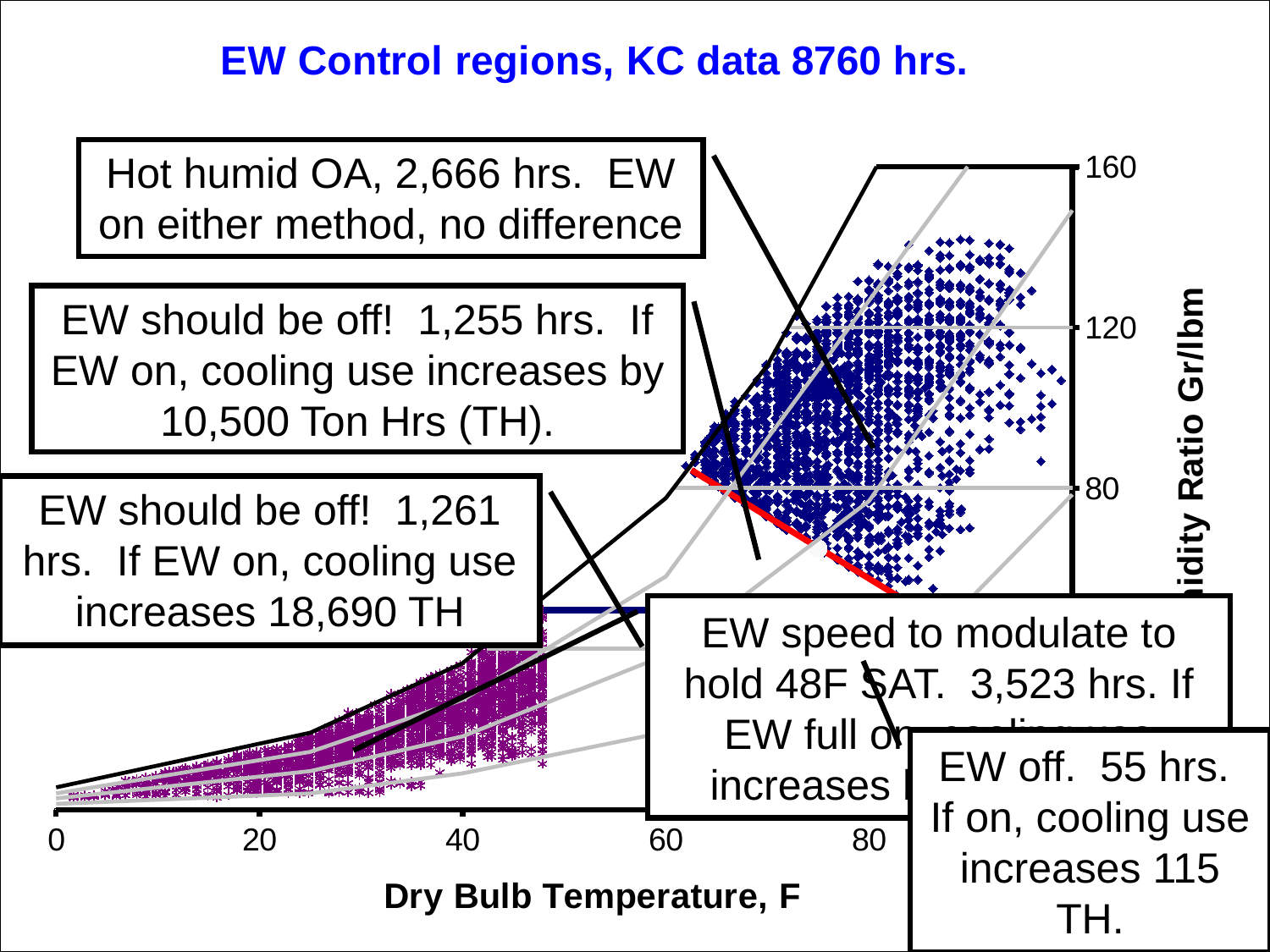
What is the difference in hours between the two 'EW should be off' regions (1,261 hrs and 1,255 hrs)? 6 hrs How many hours are in the 'Hot humid OA' region? 2,666 hrs. Which annotated control region has the fewest hours? EW off. 55 hrs. What is the total of the hours listed in the five annotation boxes (2,666 + 1,255 + 1,261 + 3,523 + 55)? 8,760 hrs How many hours are in the region where EW speed modulates to hold 48F SAT? 3,523 hrs. By how many Ton Hrs does cooling use increase in the 1,255 hrs 'EW should be off' region if EW is on? 10,500 Ton Hrs (TH) What is the title of the chart? EW Control regions, KC data 8760 hrs. Which annotated control region has the most hours? EW speed to modulate to hold 48F SAT, 3,523 hrs. Which region has more hours: 'Hot humid OA' or the 'EW should be off' region with 10,500 TH? Hot humid OA (2,666 hrs) What kind of chart is shown on the slide? scatter chart What is the label of the x axis? Dry Bulb Temperature, F By how many TH does cooling use increase in the 1,261 hrs 'EW should be off' region if EW is on? 18,690 TH